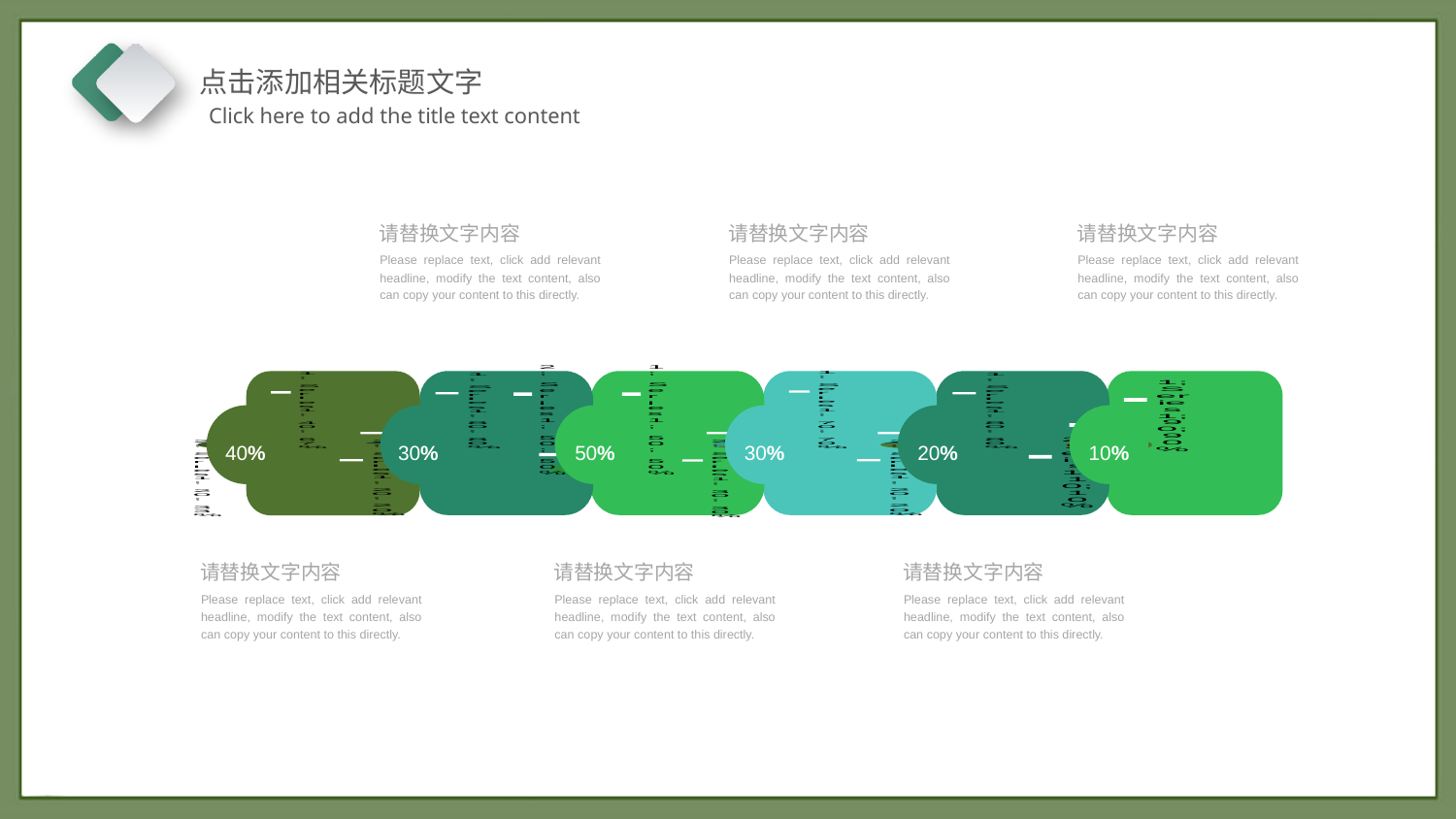
What percentage is shown in the last (rightmost) shape of the row? 10% What percentage is shown in the third shape from the left in the row of shapes? 50% Which position in the row of shapes shows the highest percentage? the third shape (50%) Which position in the row of shapes shows the lowest percentage? the last shape (10%) What percentage is shown in the first (leftmost) shape of the row of green shapes? 40% Do the percentages in the last three shapes rise or fall from left to right? fall What is the difference between the percentage in the first shape and the percentage in the fifth shape? 20% How many percentage shapes are in the row across the middle of the slide? 6 What is the difference between the percentage in the third shape and the percentage in the last shape? 40% Which is larger, the percentage in the first shape or the percentage in the second shape? the first shape (40%) What percentage is shown in the fifth shape from the left in the row? 20%